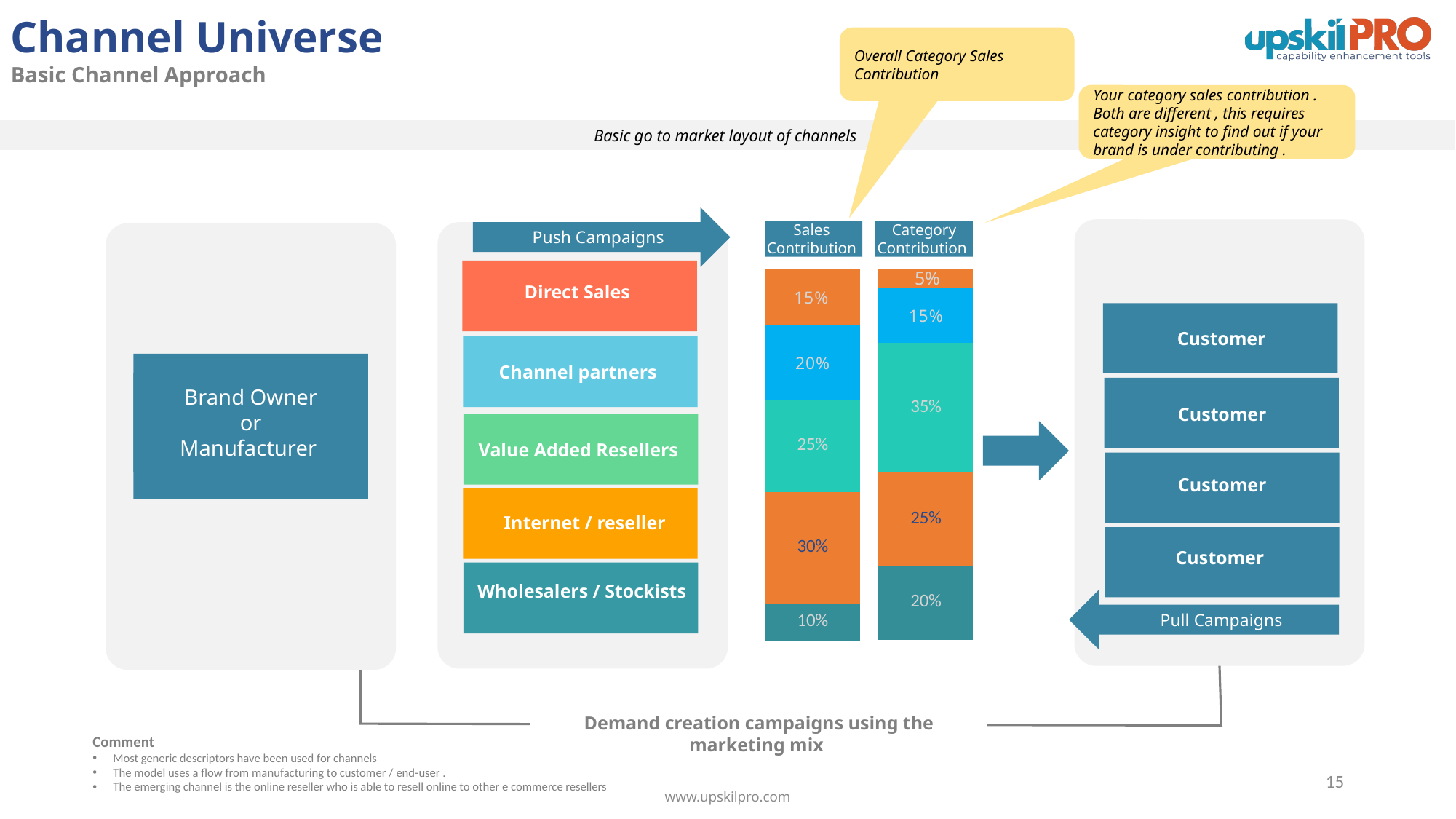
What is the top segment value of the Category Contribution stacked bar? 5% What kind of chart is used to show Sales Contribution and Category Contribution? Stacked bar chart How many segments does the Sales Contribution stacked bar have? 5 What is the top segment value of the Sales Contribution stacked bar? 15% What is the smallest segment value in the Category Contribution stacked bar? 5% What are the titles of the two stacked bars on the slide? Sales Contribution and Category Contribution What is the difference between the largest segment of the Sales Contribution bar (30%) and the largest segment of the Category Contribution bar (35%)? 5% What is the largest segment value in the Category Contribution stacked bar? 35% Which is larger: the bottom segment of the Sales Contribution bar or the bottom segment of the Category Contribution bar? Category Contribution (20%) What is the largest segment value in the Sales Contribution stacked bar? 30% What is the bottom segment value of the Sales Contribution stacked bar? 10% What is the total of all segments in the Category Contribution stacked bar? 100%